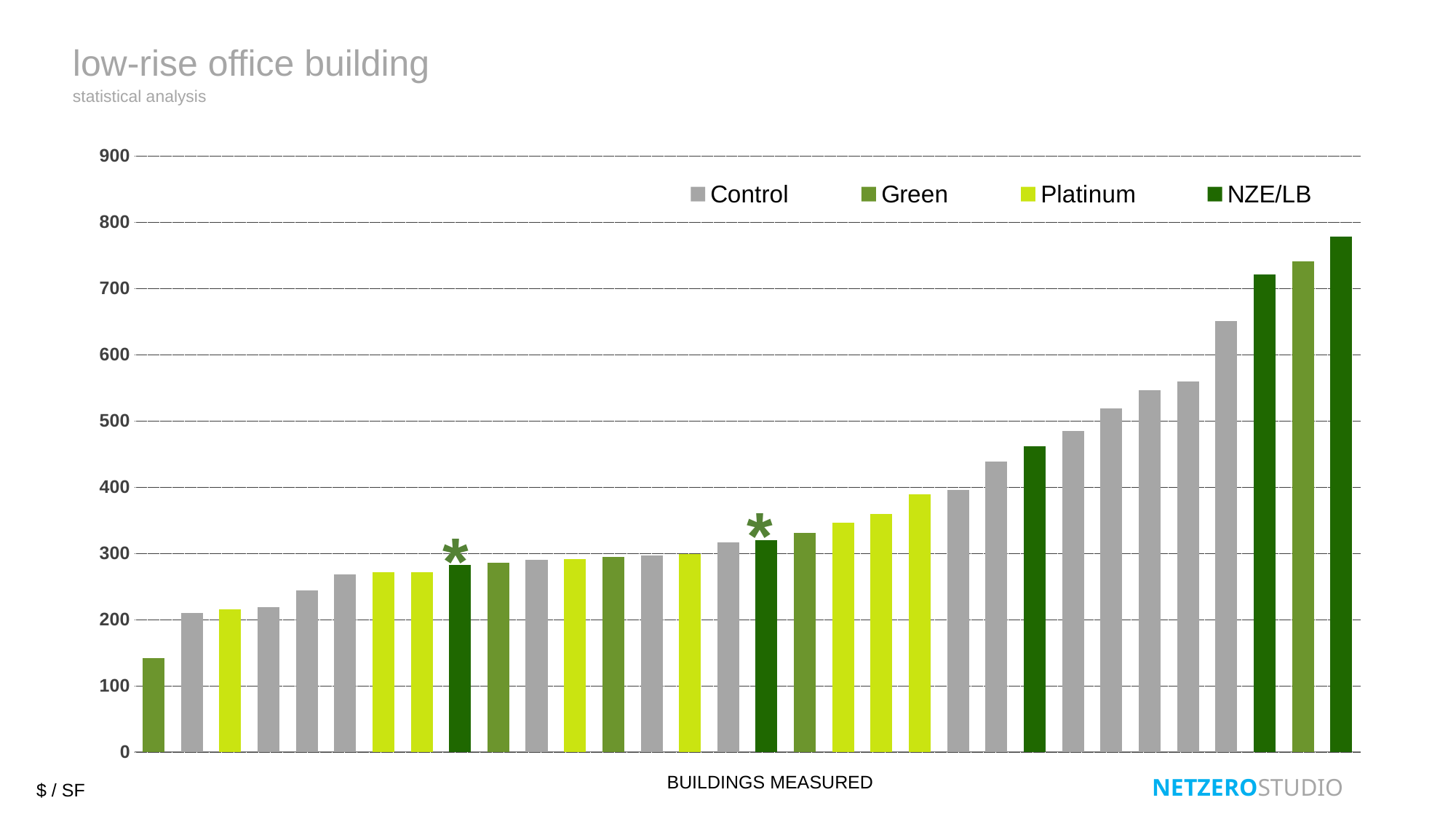
How many NZE/LB bars are plotted in the chart? 5 Which series does the shortest bar belong to? Green Which series does the tallest bar belong to? NZE/LB What kind of chart is shown on the slide? bar chart How many bars are plotted in the chart? 32 How many series does the legend list? 4 What are the series names listed in the legend? Control, Green, Platinum, NZE/LB Which is larger, the leftmost bar or the rightmost bar? the rightmost bar Is the value of the leftmost bar greater or less than 200? less What unit is shown on the vertical axis label? $ / SF Is the value of the tallest bar greater or less than 700? greater Do the bar values rise or fall from left to right along the x axis? rise